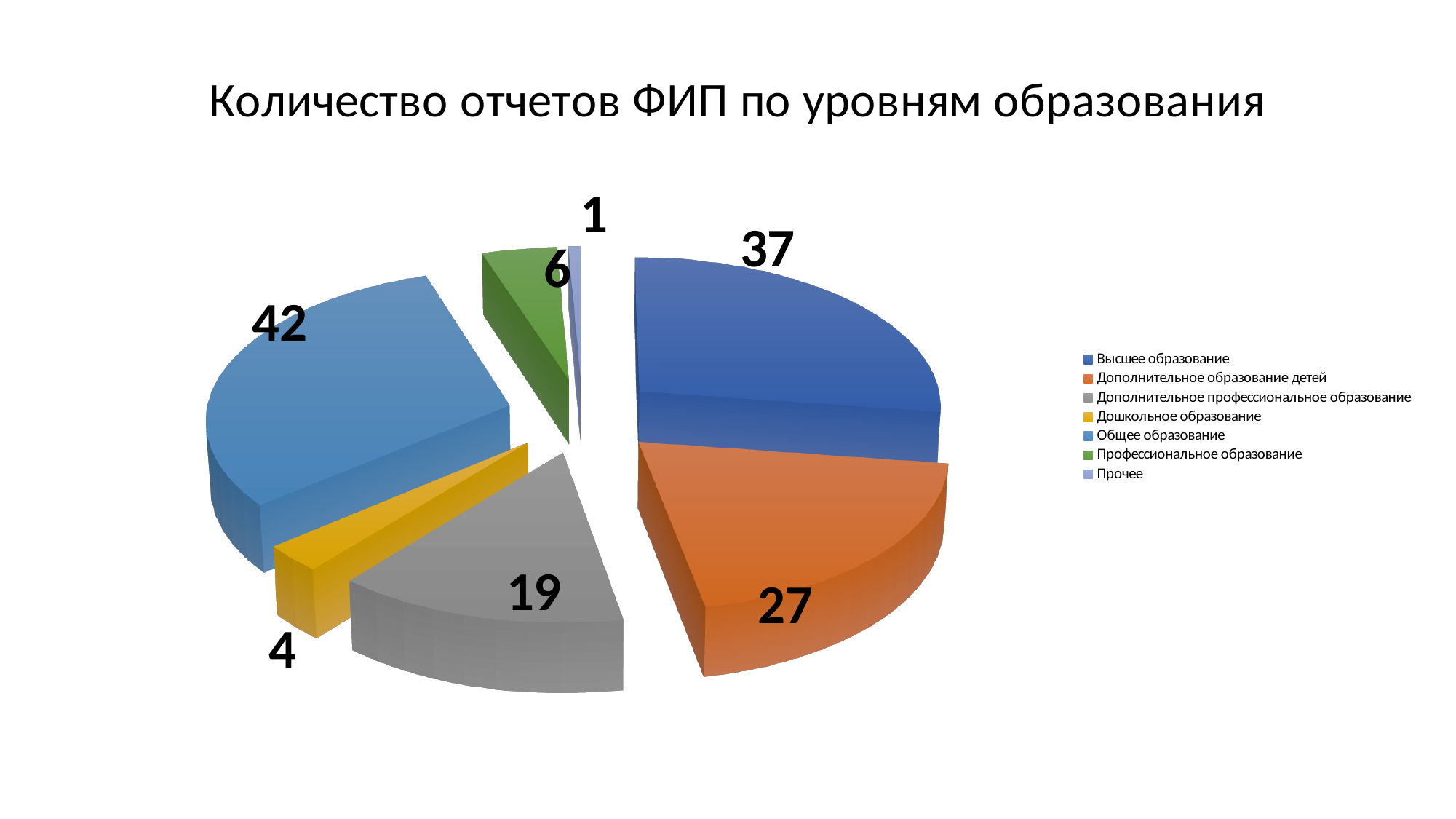
Which category has the highest value? Общее образование What is the title of the chart? Количество отчетов ФИП по уровням образования Which category has the lowest value? Прочее What is the value for Высшее образование? 37 What is the value for Дополнительное образование детей? 27 What is the difference between the values for Общее образование and Высшее образование? 5 What kind of chart is shown on the slide? pie chart How many categories does the pie chart have? 7 Which is larger: Дополнительное образование детей or Дополнительное профессиональное образование? Дополнительное образование детей What is the total of all the values in the pie chart? 136 What is the value for Профессиональное образование? 6 What is the value for Дошкольное образование? 4